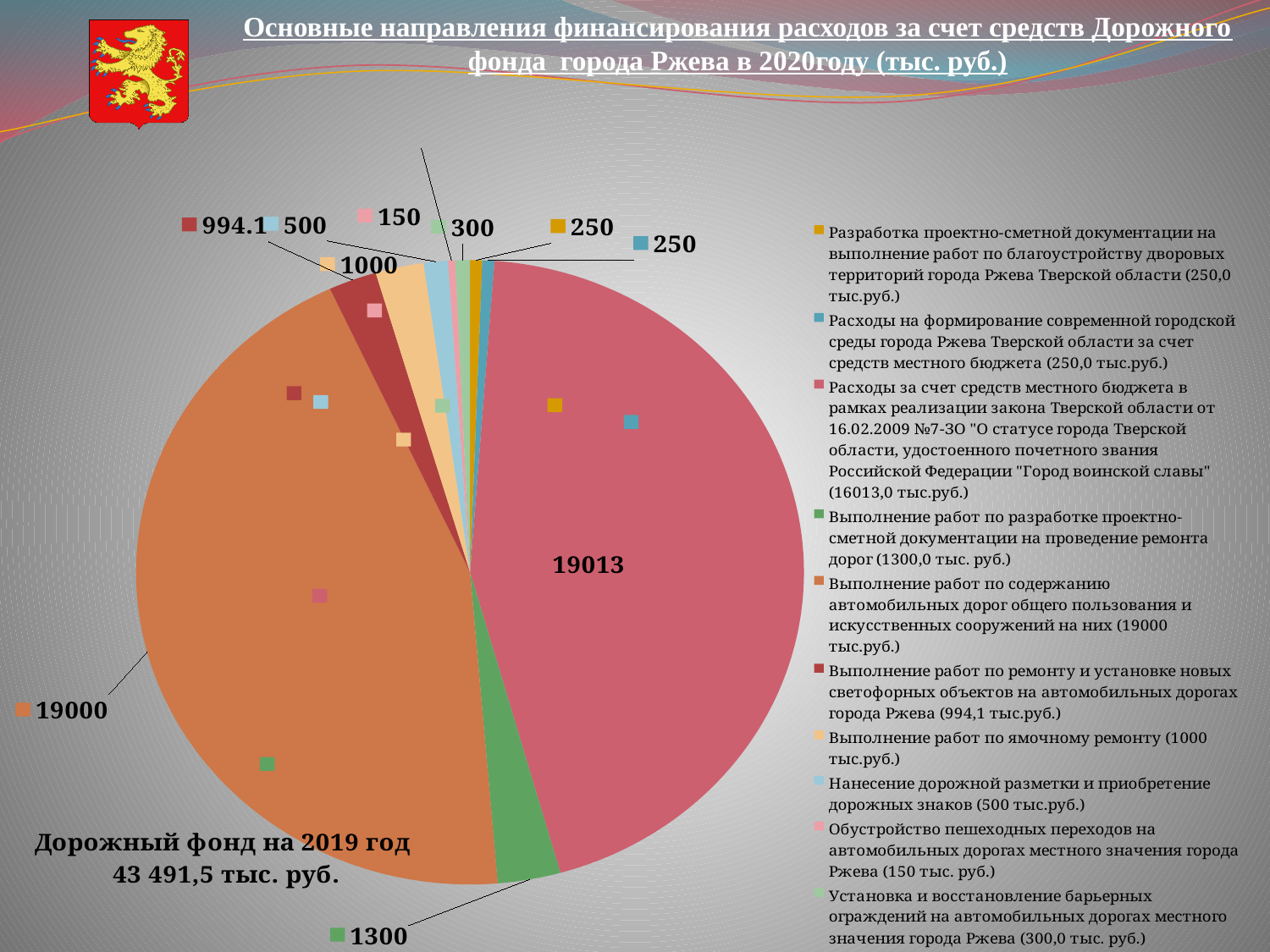
What value is labelled on the slice for "Выполнение работ по ямочному ремонту"? 1000 What total amount of the road fund for 2019 is stated in the text on the slide? 43 491,5 тыс. руб. Which is larger: the slice for "Выполнение работ по разработке проектно-сметной документации на проведение ремонта дорог" or the slice for "Выполнение работ по ремонту и установке новых светофорных объектов"? Выполнение работ по разработке проектно-сметной документации на проведение ремонта дорог (1300) What is the difference between the slice labelled 19000 and the slice labelled 1300? 17700 What type of chart is shown on the slide? pie chart What value is labelled on the slice for "Нанесение дорожной разметки и приобретение дорожных знаков"? 500 What value is labelled on the slice for "Выполнение работ по ремонту и установке новых светофорных объектов"? 994.1 How many slices does the pie chart have? 10 Which category has the smallest slice in the pie chart? Обустройство пешеходных переходов на автомобильных дорогах местного значения города Ржева (150) What value is labelled on the slice for "Установка и восстановление барьерных ограждений"? 300 What is the difference between the slice labelled 1300 and the slice labelled 1000? 300 How many entries does the legend of the pie chart list? 10